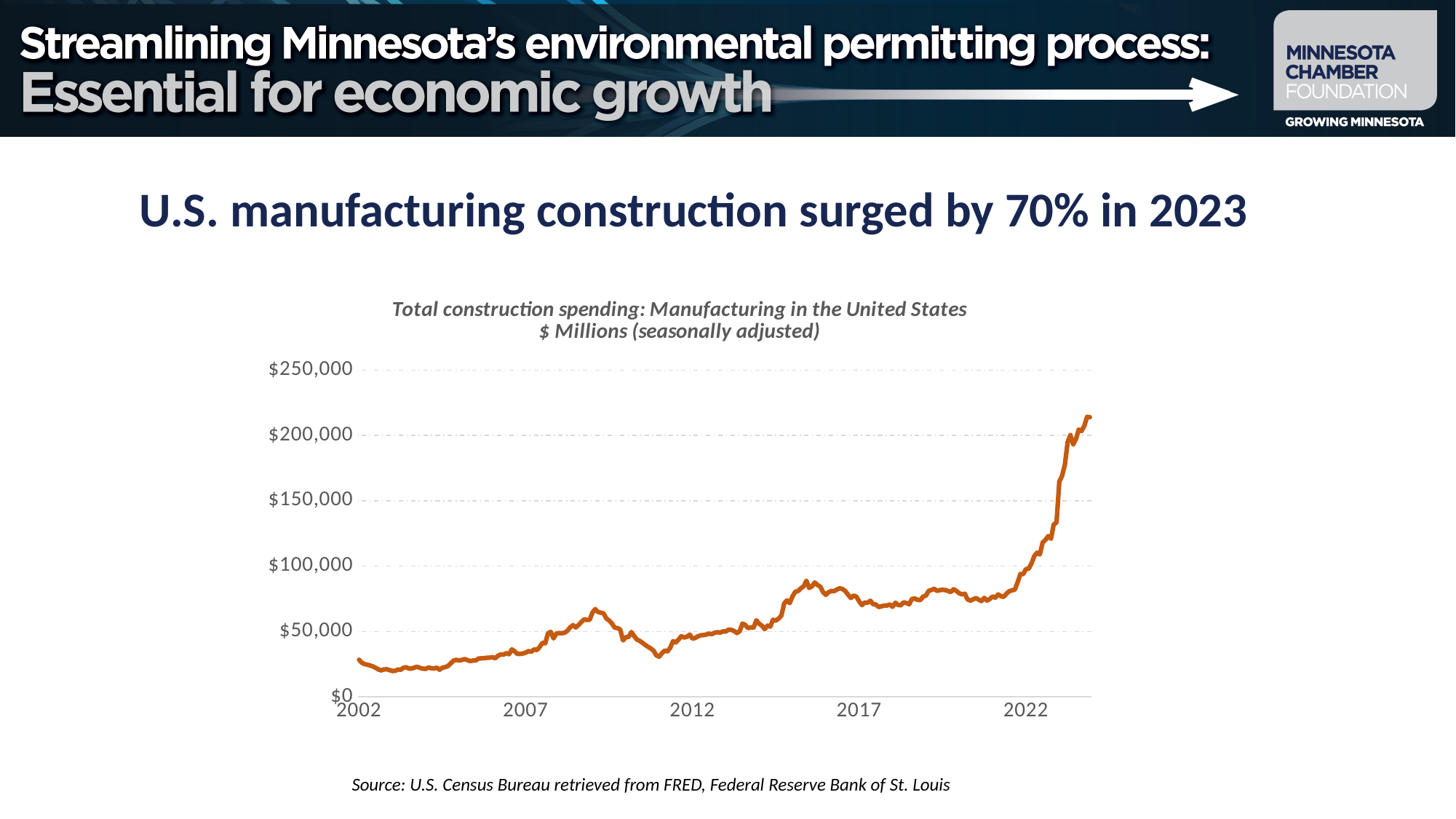
What is the source cited below the chart? U.S. Census Bureau retrieved from FRED, Federal Reserve Bank of St. Louis Is the peak reached around 2008-2009 greater or less than $100,000? less What kind of chart is shown on the slide? Line chart What is the title of the chart? Total construction spending: Manufacturing in the United States $ Millions (seasonally adjusted) Overall, do the values rise or fall from 2002 to the end of the series? Rise Is the value in 2012 greater or less than $50,000? less How many lines are plotted on the chart? 1 Is the highest value on the chart greater or less than $250,000? less